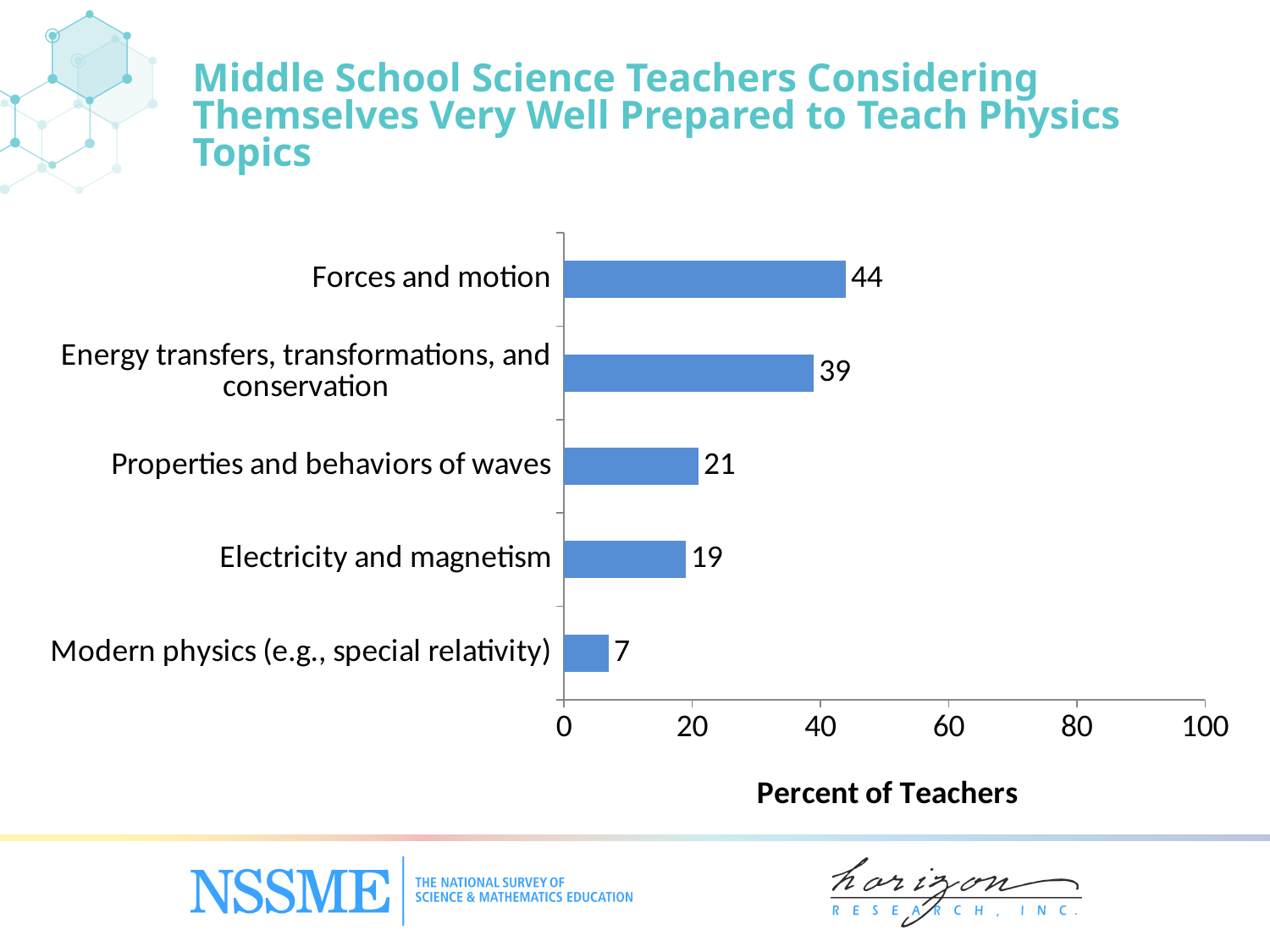
What kind of chart is shown on the slide? bar chart Which topic has the highest percent of teachers? Forces and motion What is the value for Modern physics (e.g., special relativity)? 7 What percent of teachers consider themselves very well prepared to teach Forces and motion? 44 How many topics are shown in the chart? 5 Is the value for Energy transfers, transformations, and conservation greater or less than 40? less What is the value for Energy transfers, transformations, and conservation? 39 What is the value for Properties and behaviors of waves? 21 What is the difference between the values for Forces and motion and Electricity and magnetism? 25 What is the label of the horizontal axis? Percent of Teachers Which is larger, the value for Properties and behaviors of waves or the value for Electricity and magnetism? Properties and behaviors of waves Which topic has the lowest percent of teachers? Modern physics (e.g., special relativity)